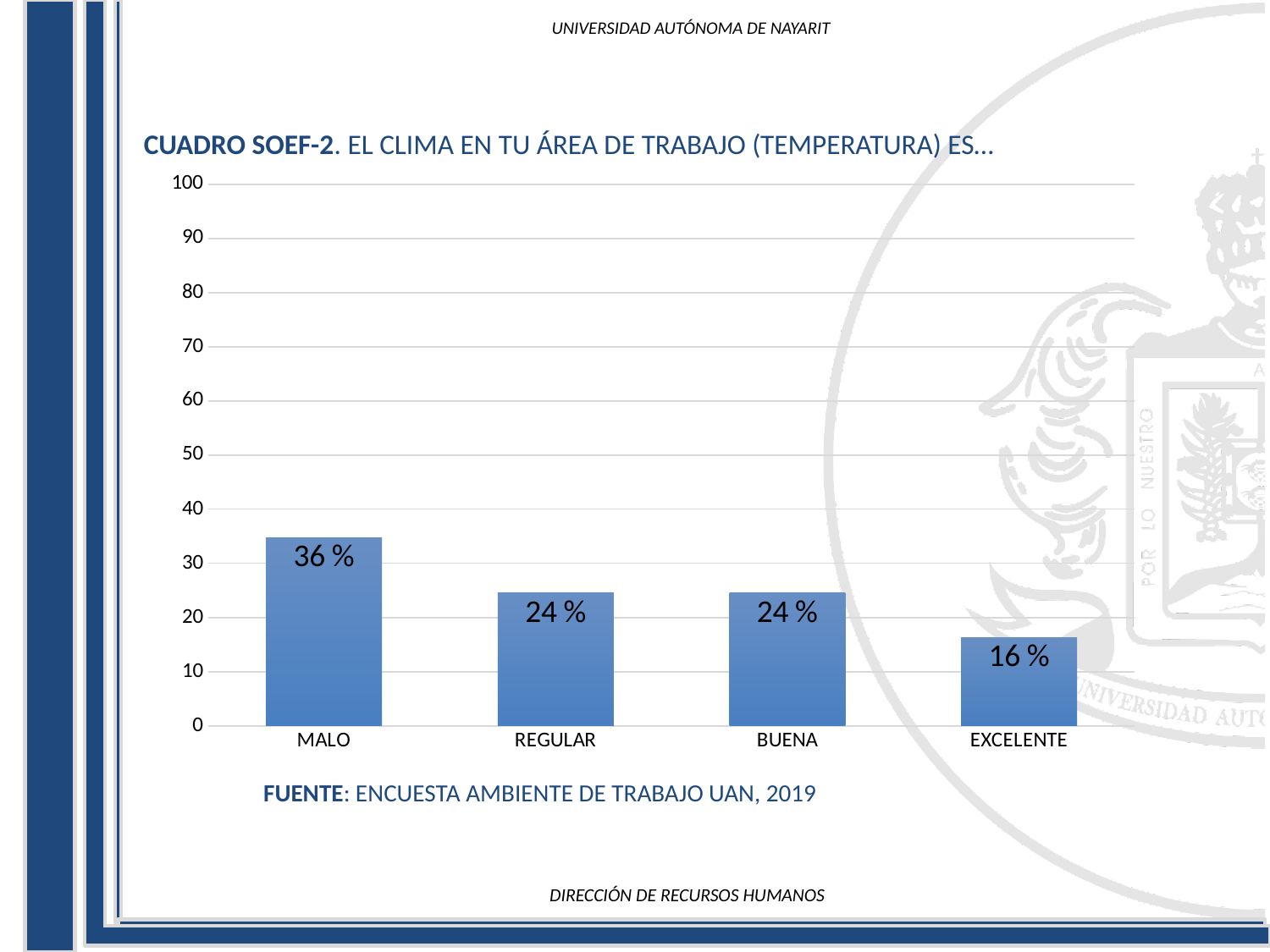
Which is larger, the value for BUENA or the value for EXCELENTE? BUENA Which category has the highest value? MALO What is the value for MALO? 36 % Which category has the lowest value? EXCELENTE What is the value for REGULAR? 24 % What is the difference between the values for MALO and EXCELENTE? 20 % What is the difference between the values for MALO and BUENA? 12 % Is the value for MALO greater or less than 30? greater What is the value for EXCELENTE? 16 % What is the source cited below the chart? ENCUESTA AMBIENTE DE TRABAJO UAN, 2019 How many categories are shown on the x axis? 4 What kind of chart is shown on the slide? bar chart